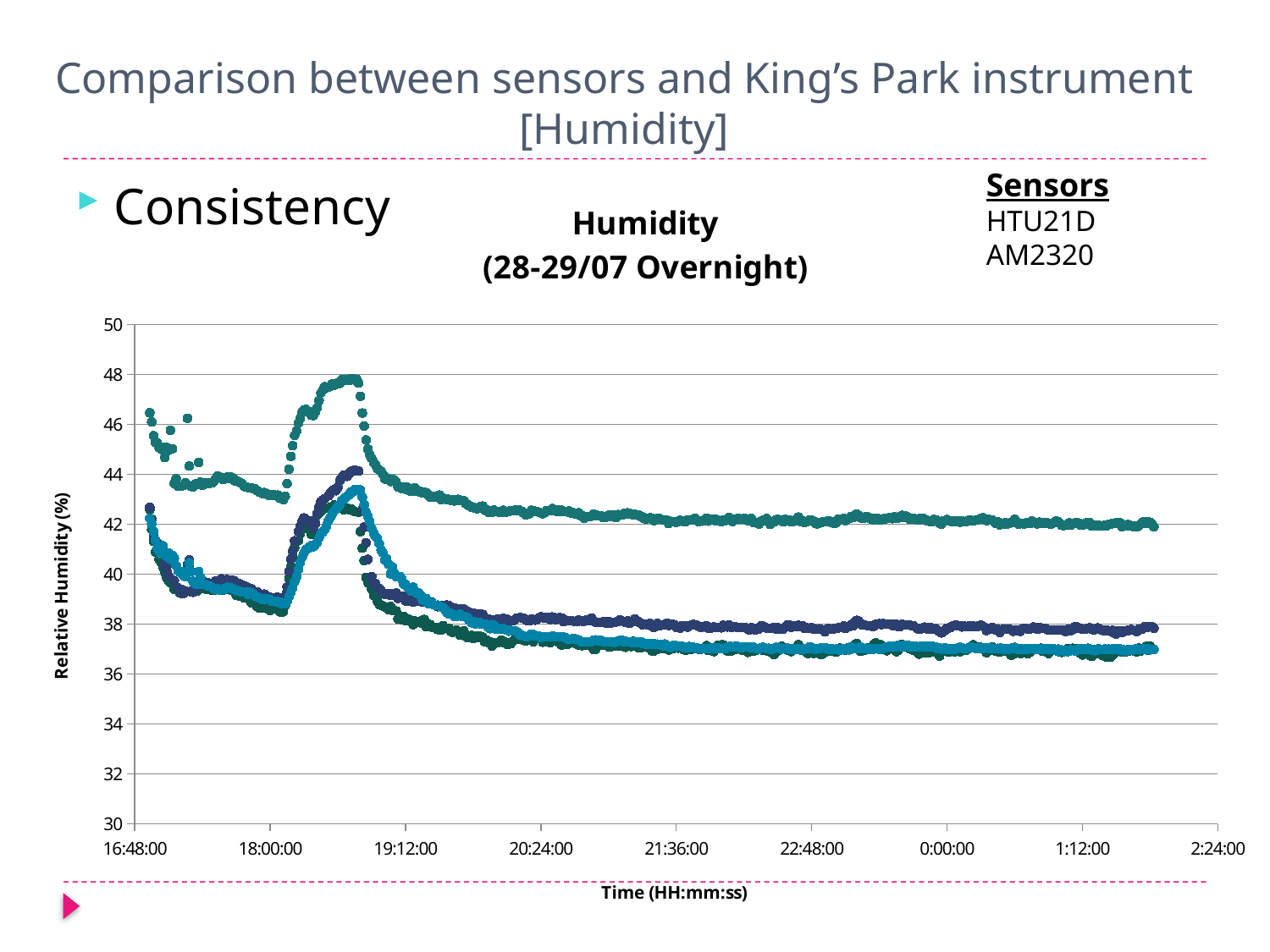
Is the lowest humidity value plotted on the chart greater or less than 36? greater What is the title of the chart? Humidity (28-29/07 Overnight) Do the plotted humidity values rise or fall between 18:00:00 and about 18:48:00? rise What is the label of the vertical axis of the chart? Relative Humidity (%) Are the humidity values plotted at 1:12:00 greater or less than 44? less Do the plotted humidity values rise or fall between 19:12:00 and 20:24:00? fall Is the highest humidity value plotted on the chart greater or less than 46? greater What is the highest value shown on the vertical axis of the chart? 50 What is the lowest value shown on the vertical axis of the chart? 30 What is the first time tick shown on the horizontal axis of the chart? 16:48:00 What type of chart is shown on the slide? scatter chart What is the last time tick shown on the horizontal axis of the chart? 2:24:00